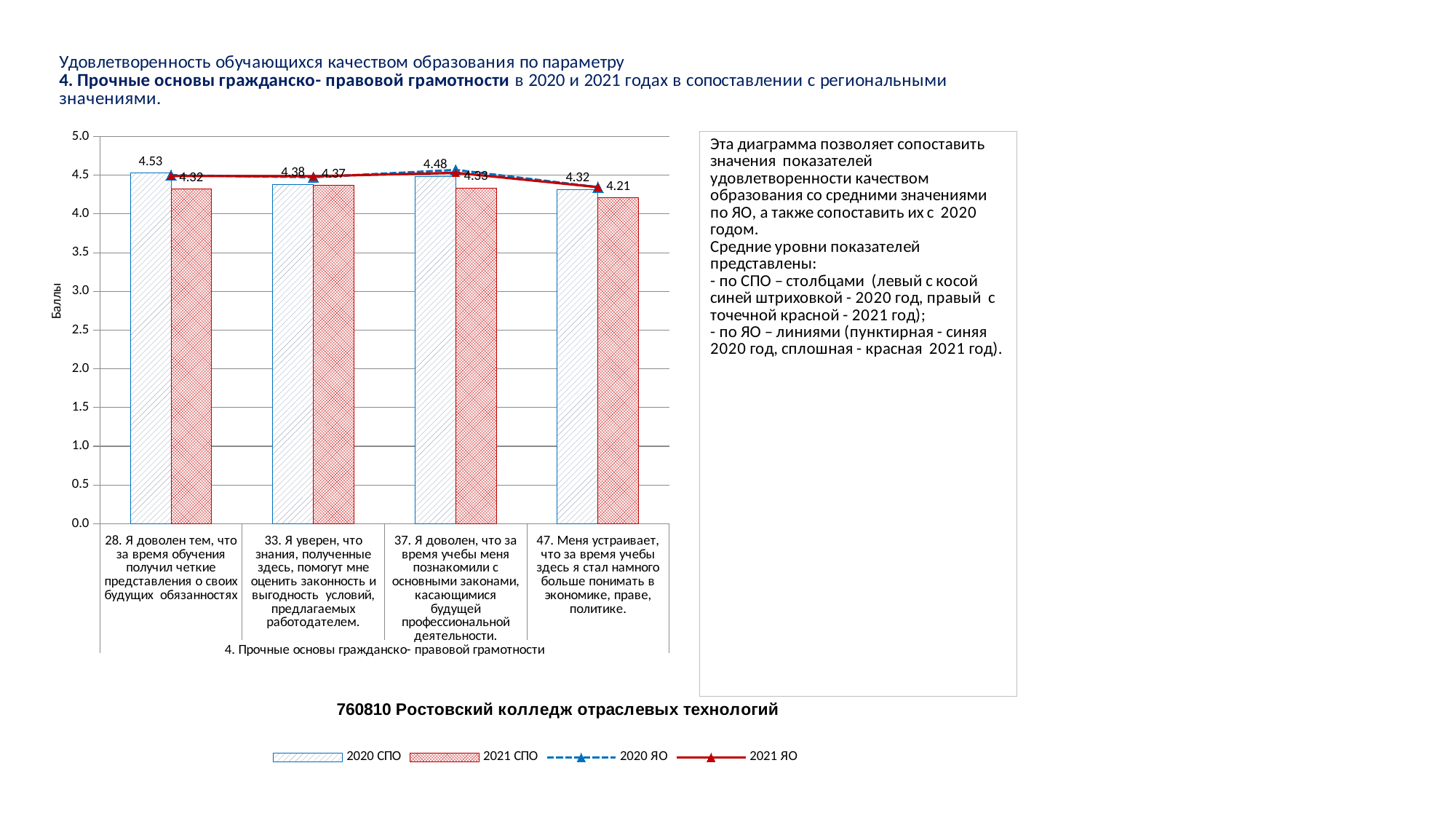
Is the 2021 СПО value for item 47 greater or less than 4.0? greater What is the label of the vertical axis of the chart? Баллы For item 37, which is larger: the 2020 СПО value or the 2021 СПО value? 2020 СПО What is the value of the 2021 СПО bar for item 33 (Я уверен, что знания, полученные здесь, помогут мне оценить законность и выгодность условий)? 4.37 Which item has the highest 2020 СПО value? 28. Я доволен тем, что за время обучения получил четкие представления о своих будущих обязанностях What is the value of the 2020 СПО bar for item 37 (Я доволен, что за время учебы меня познакомили с основными законами)? 4.48 What is the difference between the 2020 СПО and 2021 СПО values for item 28? 0.21 How many items (categories) are shown on the x axis of the chart? 4 How many series does the chart legend list? 4 What is the value of the 2020 СПО bar for item 28 (Я доволен тем, что за время обучения получил четкие представления о своих будущих обязанностях)? 4.53 Which item has the lowest 2021 СПО value? 47. Меня устраивает, что за время учебы здесь я стал намного больше понимать в экономике, праве, политике What is the value of the 2021 СПО bar for item 47 (Меня устраивает, что за время учебы здесь я стал намного больше понимать в экономике, праве, политике)? 4.21